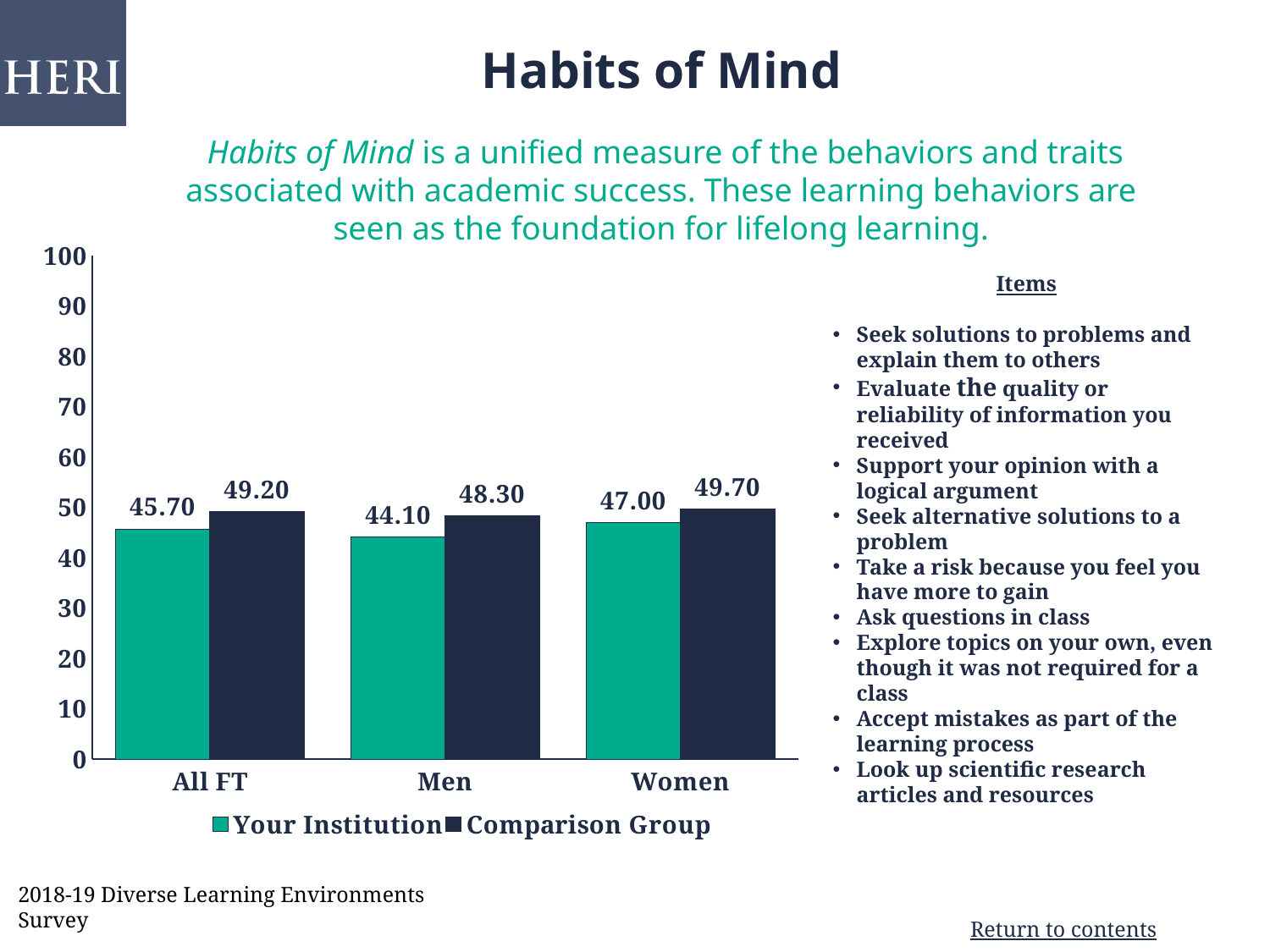
Which category has the lowest value for the Your Institution series? Men What is the title of the slide containing the chart? Habits of Mind Is the value for Your Institution in the Women category greater or less than 50? less Which category has the highest value for the Comparison Group series? Women What kind of chart is shown on the slide? bar chart How many series does the legend list? 2 What is the difference between the Comparison Group and Your Institution values in the Men category? 4.20 Which is larger in the Women category: Your Institution or Comparison Group? Comparison Group What is the value for Your Institution in the All FT category? 45.70 How many categories are shown on the x axis? 3 What is the value for Your Institution in the Men category? 44.10 What is the value for Comparison Group in the Women category? 49.70